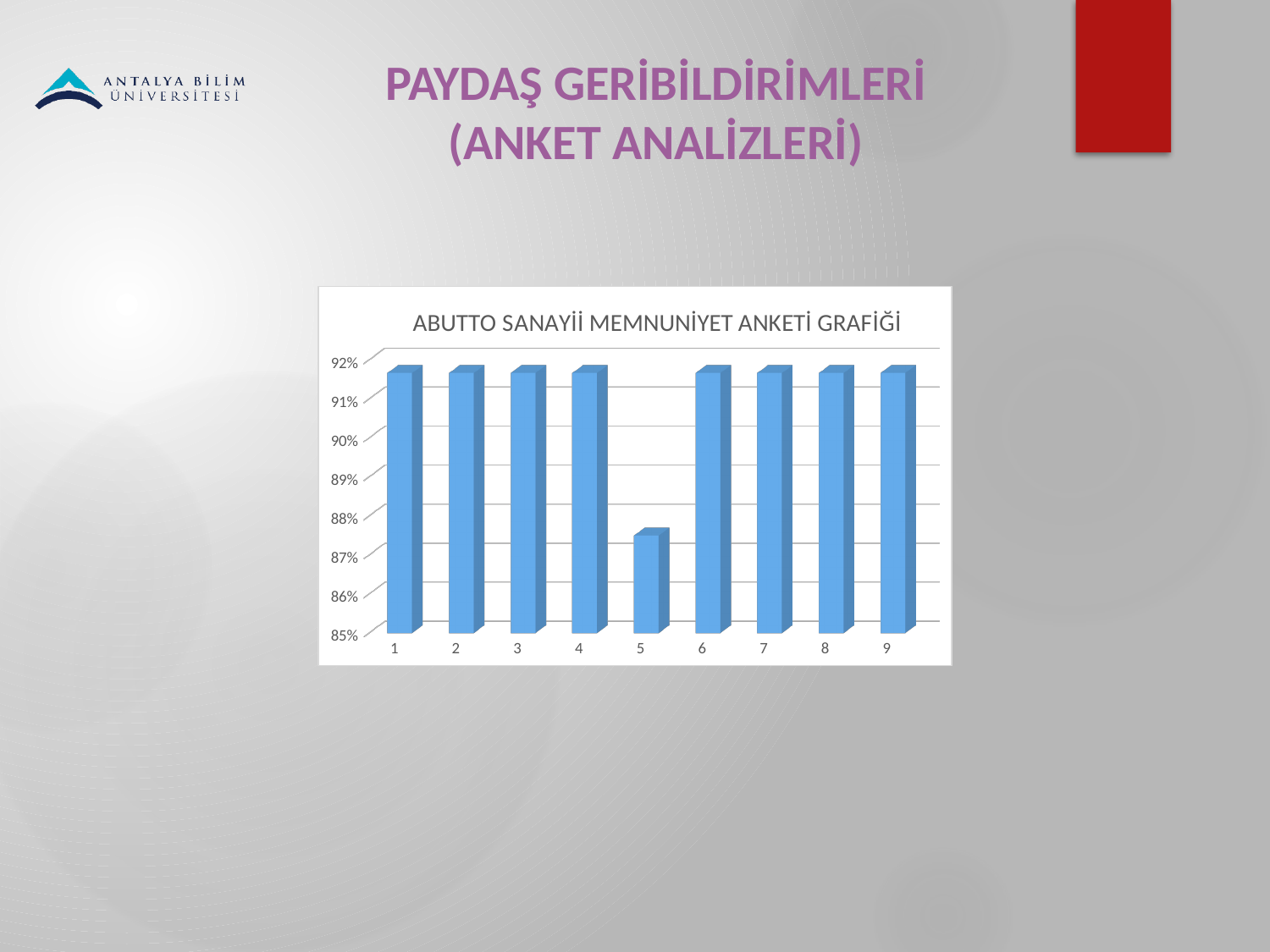
What is the lowest value shown on the y axis of the chart? 85% Is the value for category 5 greater or less than 90%? less What kind of chart is shown on the slide? bar chart How many categories are plotted on the x axis of the chart? 9 Which is larger, the value for category 4 or the value for category 5? category 4 Is the value for category 5 greater or less than 88%? less Is the value for category 5 greater or less than 87%? greater Which category has the lowest value in the chart? 5 Which is larger, the value for category 5 or the value for category 6? category 6 What is the title of the chart? ABUTTO SANAYİİ MEMNUNİYET ANKETİ GRAFİĞİ